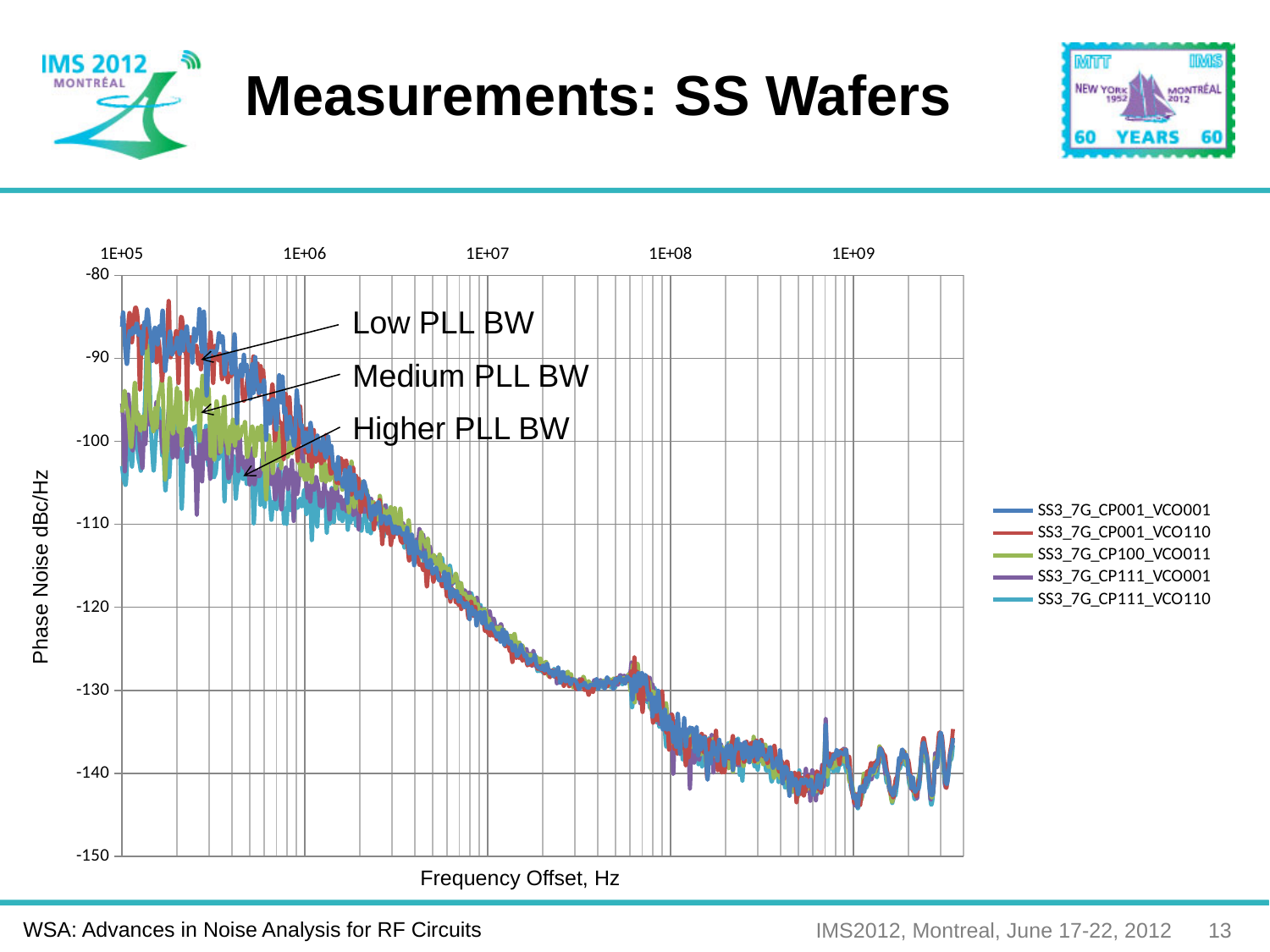
How many labelled tick values are shown on the x axis? 5 Which annotation on the chart points to the lowest curves at low frequency offsets? Higher PLL BW Is the value for SS3_7G_CP111_VCO110 at a frequency offset of 1E+09 greater or less than -130? less At a frequency offset of 1E+05, which series has the larger value: SS3_7G_CP001_VCO001 or SS3_7G_CP111_VCO110? SS3_7G_CP001_VCO001 What is the label of the x axis? Frequency Offset, Hz What is the label of the y axis? Phase Noise dBc/Hz Is the value for SS3_7G_CP100_VCO011 at a frequency offset of 1E+08 greater or less than -120? less Is the value for SS3_7G_CP001_VCO001 at a frequency offset of 1E+05 greater or less than -100? greater What kind of chart is shown on the slide? line chart How many series does the legend list? 5 Do the phase noise values generally rise or fall as the frequency offset increases along the x axis? fall